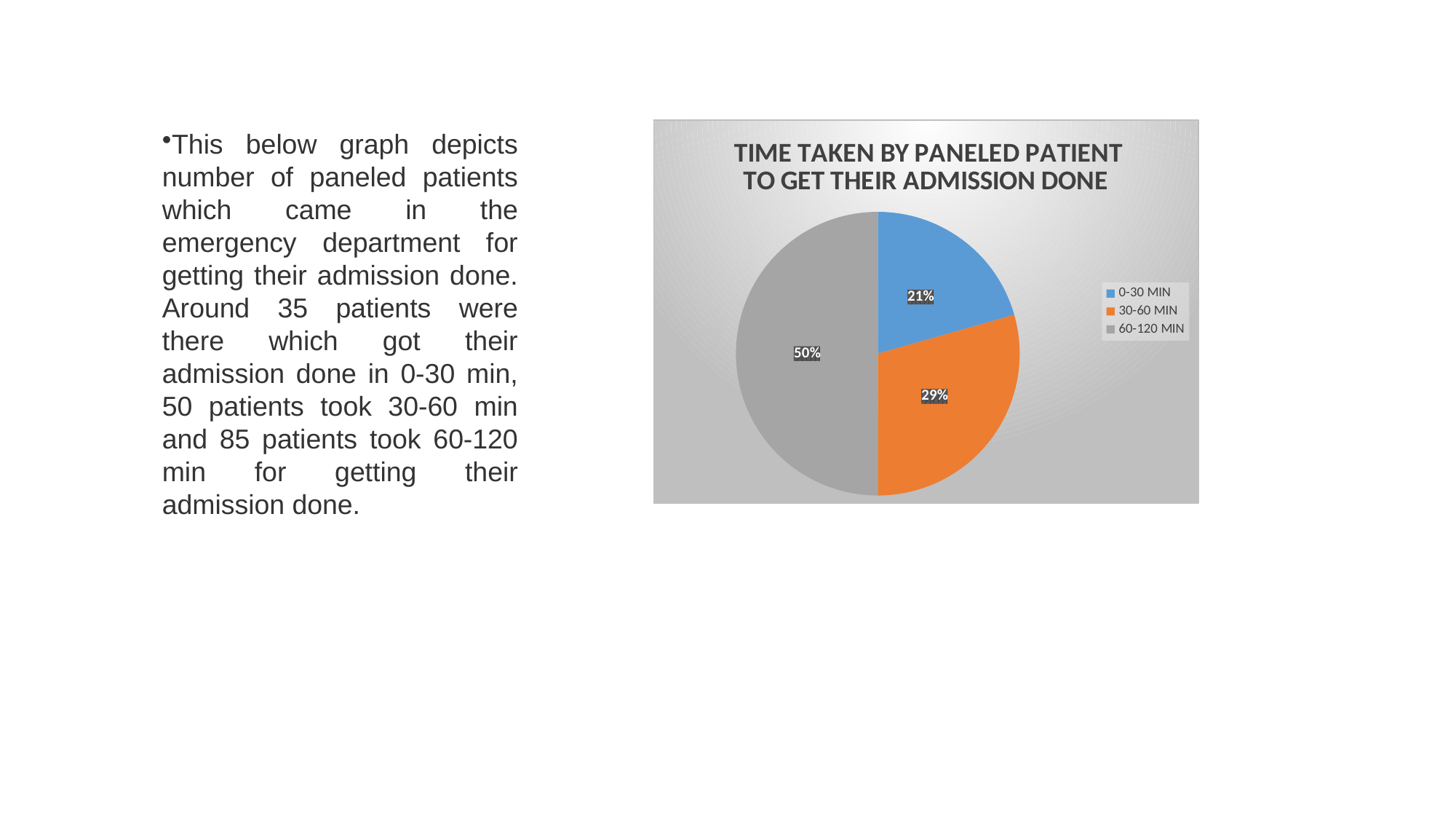
What share of the pie does the 0-30 MIN slice represent? 21% Which category has the smallest slice of the pie? 0-30 MIN What is the title of the chart? TIME TAKEN BY PANELED PATIENT TO GET THEIR ADMISSION DONE Which slice is larger, 0-30 MIN or 30-60 MIN? 30-60 MIN What is the difference in percentage points between the 30-60 MIN slice and the 0-30 MIN slice? 8% What share of the pie does the 30-60 MIN slice represent? 29% What is the difference in percentage points between the 60-120 MIN slice and the 30-60 MIN slice? 21% What colour is the 60-120 MIN slice? grey What kind of chart is shown on the slide? pie chart How many categories does the legend list? 3 Which category has the largest slice of the pie? 60-120 MIN What share of the pie does the 60-120 MIN slice represent? 50%